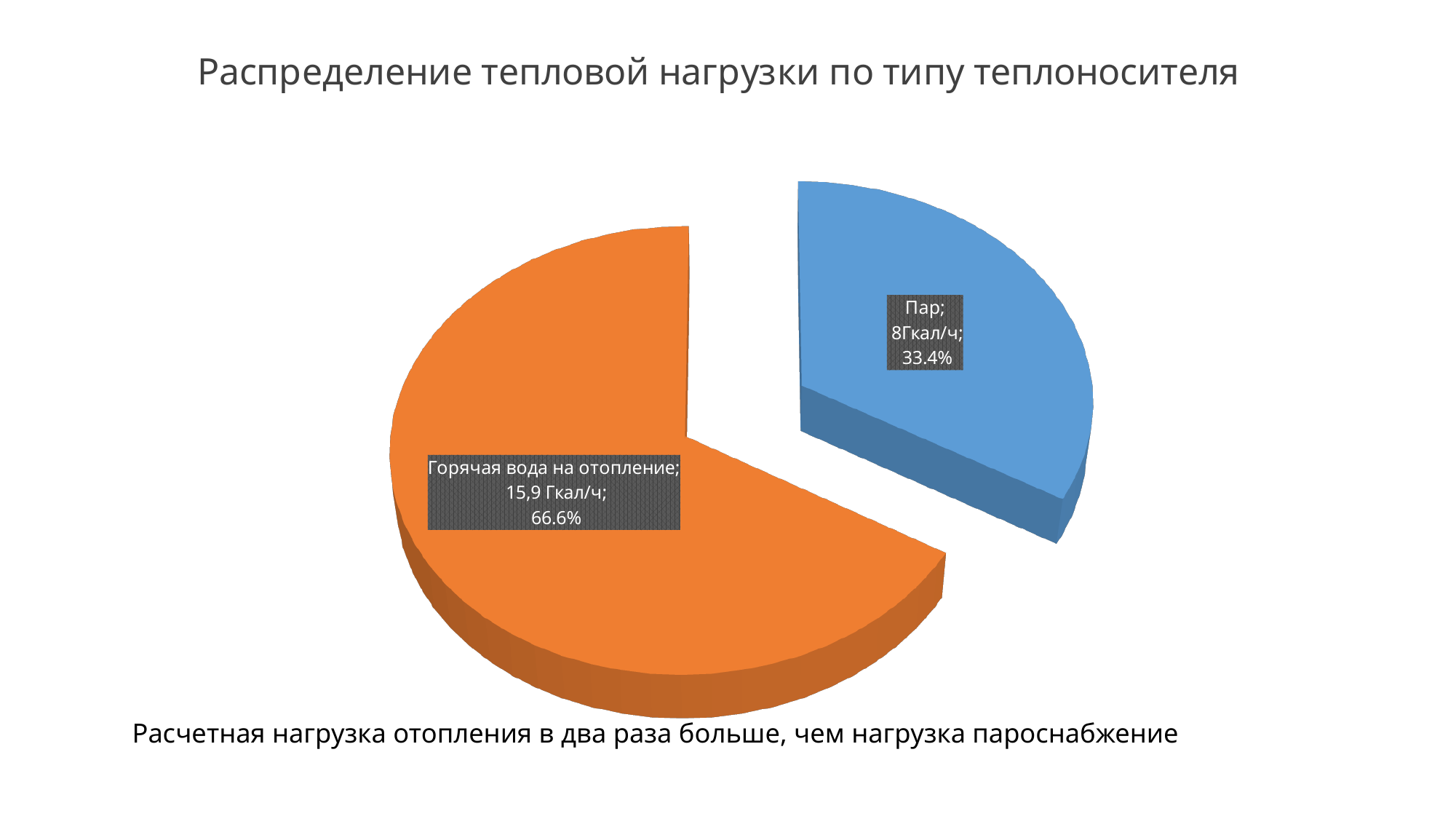
Which category has the largest slice? Горячая вода на отопление What colour is the slice for Пар? Blue What is the title of the chart? Распределение тепловой нагрузки по типу теплоносителя What share of the pie does Горячая вода на отопление represent? 66.6% What is the value for Пар? 8Гкал/ч What share of the pie does Пар represent? 33.4% What type of chart is shown on the slide? Pie chart Which category has the smallest slice? Пар What is the value for Горячая вода на отопление? 15,9 Гкал/ч What is the difference in percentage share between Горячая вода на отопление and Пар? 33.2% Which is larger, the value for Пар or for Горячая вода на отопление? Горячая вода на отопление How many slices does the pie chart have? 2